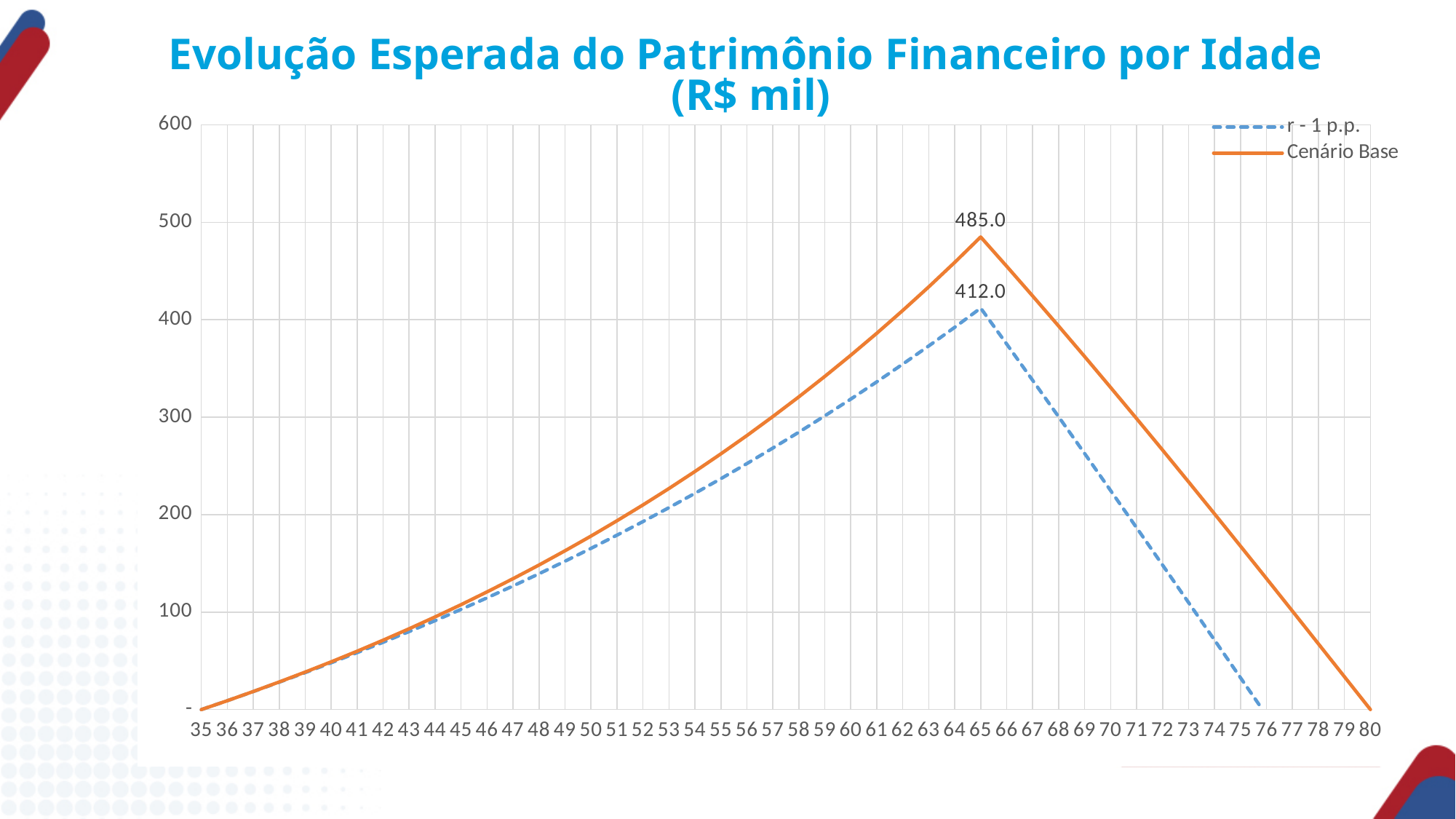
What kind of chart is shown on the slide? Line chart Do the values of the Cenário Base series rise or fall between age 65 and age 80? Fall What is the difference between the Cenário Base and r - 1 p.p. values at age 65? 73.0 Is the value of the Cenário Base series at age 40 greater or less than 100? less How many age categories are shown on the x axis? 46 Is the value of the Cenário Base series at age 60 greater or less than 300? greater At which age does the Cenário Base series reach its highest value? 65 What is the value of the Cenário Base series at age 65? 485.0 What is the value of the r - 1 p.p. series at age 65? 412.0 At age 65, which series has the higher value, Cenário Base or r - 1 p.p.? Cenário Base Which series is drawn with a dashed line? r - 1 p.p. How many series does the legend list? 2